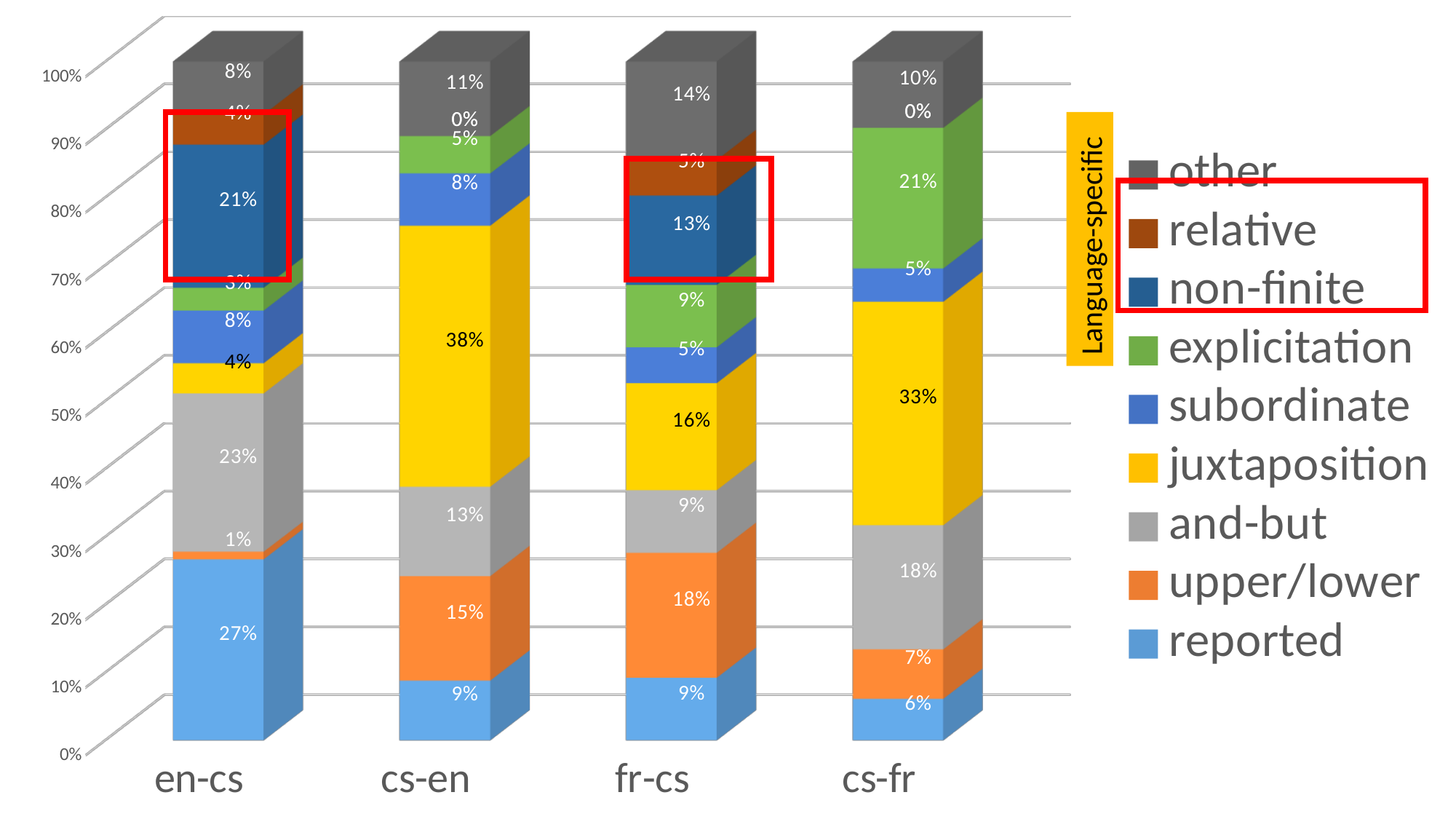
What is the value for upper/lower in the fr-cs bar? 18% What is the value for reported in the en-cs bar? 27% What is the value for juxtaposition in the cs-en bar? 38% What is the difference between the non-finite value for en-cs and for fr-cs? 8% Which language pair has the highest value for juxtaposition? cs-en What is the value for non-finite in the fr-cs bar? 13% Which language pair has the lowest value for reported? cs-fr What kind of chart is shown on the slide? stacked bar chart Which is larger, the and-but value for en-cs or for cs-fr? en-cs How many series does the legend list? 9 How many language pairs are shown on the x axis? 4 What is the value for explicitation in the cs-fr bar? 21%